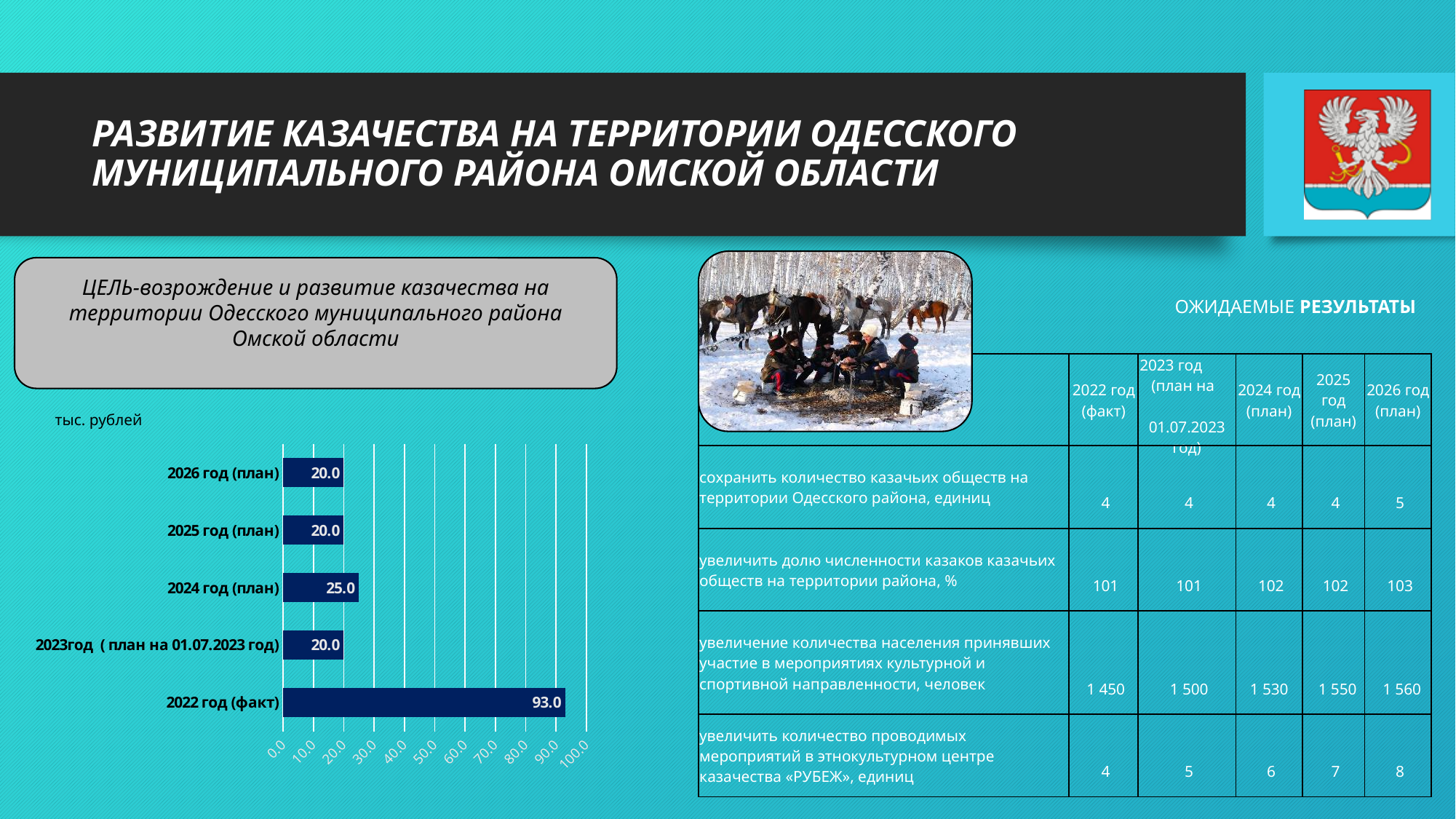
What is the difference between the values for 2022 год (факт) and 2024 год (план) in the bar chart? 68.0 What is the value for 2022 год (факт) in the bar chart? 93.0 Which category has the highest value in the bar chart? 2022 год (факт) What is the value for 2023год (план на 01.07.2023 год) in the bar chart? 20.0 What is the value for 2024 год (план) in the bar chart? 25.0 How many categories are shown in the bar chart? 5 What type of chart is shown on the left of the slide? bar chart Which is larger in the bar chart: the value for 2024 год (план) or the value for 2025 год (план)? 2024 год (план) What is the value for 2026 год (план) in the bar chart? 20.0 Is the value for 2022 год (факт) in the bar chart greater or less than 90.0? greater What is the difference between the values for 2024 год (план) and 2025 год (план) in the bar chart? 5.0 What unit is indicated above the bar chart? тыс. рублей